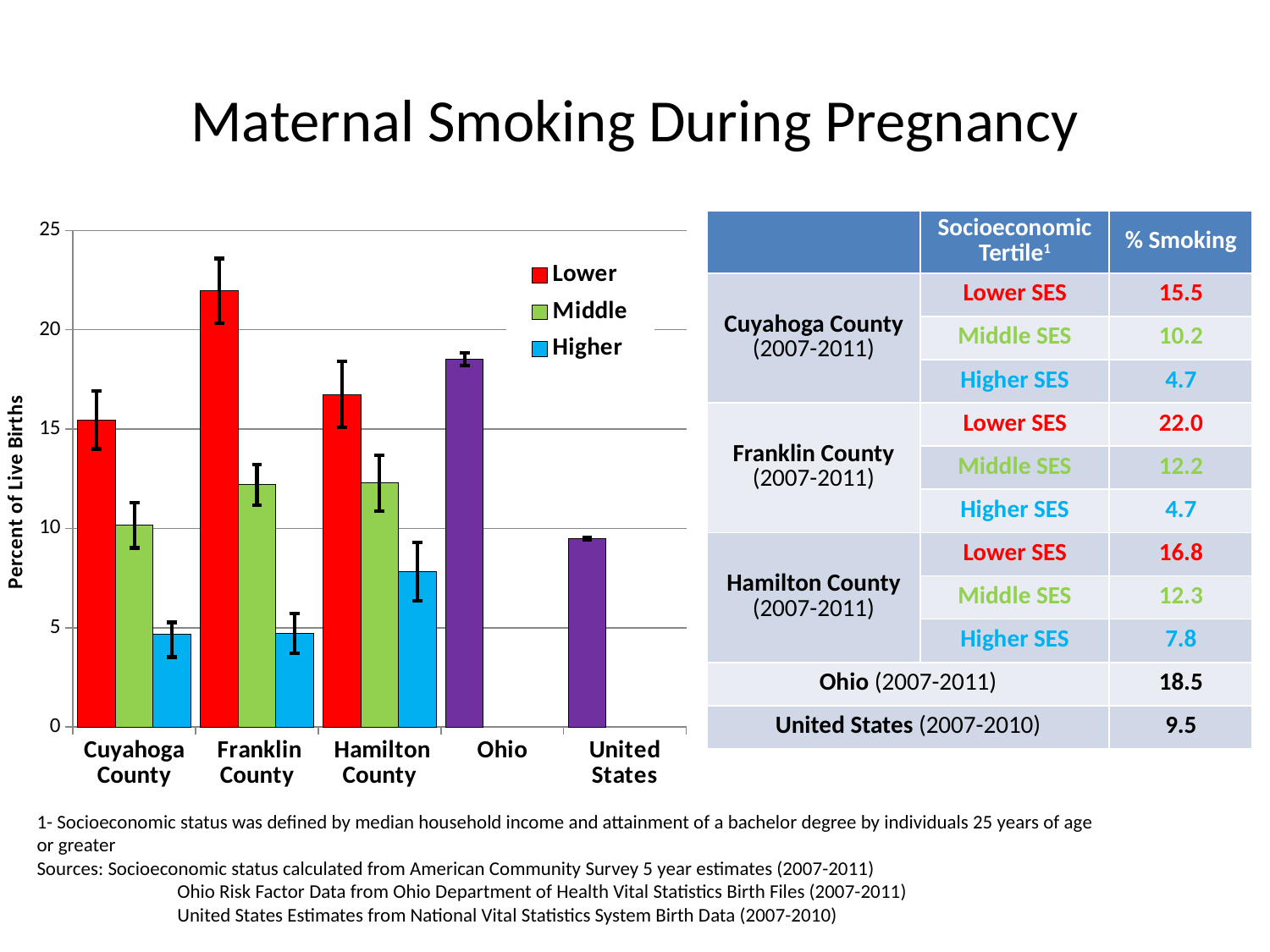
How many categories are shown along the x axis of the chart? 5 Which county has the highest Lower SES maternal smoking percentage? Franklin County Is the Lower SES value for Franklin County greater or less than 20? greater Which is larger, the Ohio value or the United States value? Ohio What is the percent smoking value for Ohio (2007-2011)? 18.5 What is the percent smoking value for the Higher SES group in Hamilton County? 7.8 How many series does the chart legend list? 3 What is the label of the y axis? Percent of Live Births What kind of chart is shown on the slide? bar chart Which group in Cuyahoga County has the lowest maternal smoking percentage? Higher SES What is the difference between the Lower SES and Higher SES smoking percentages in Franklin County? 17.3 What is the percent of live births with maternal smoking for the Lower SES group in Franklin County? 22.0